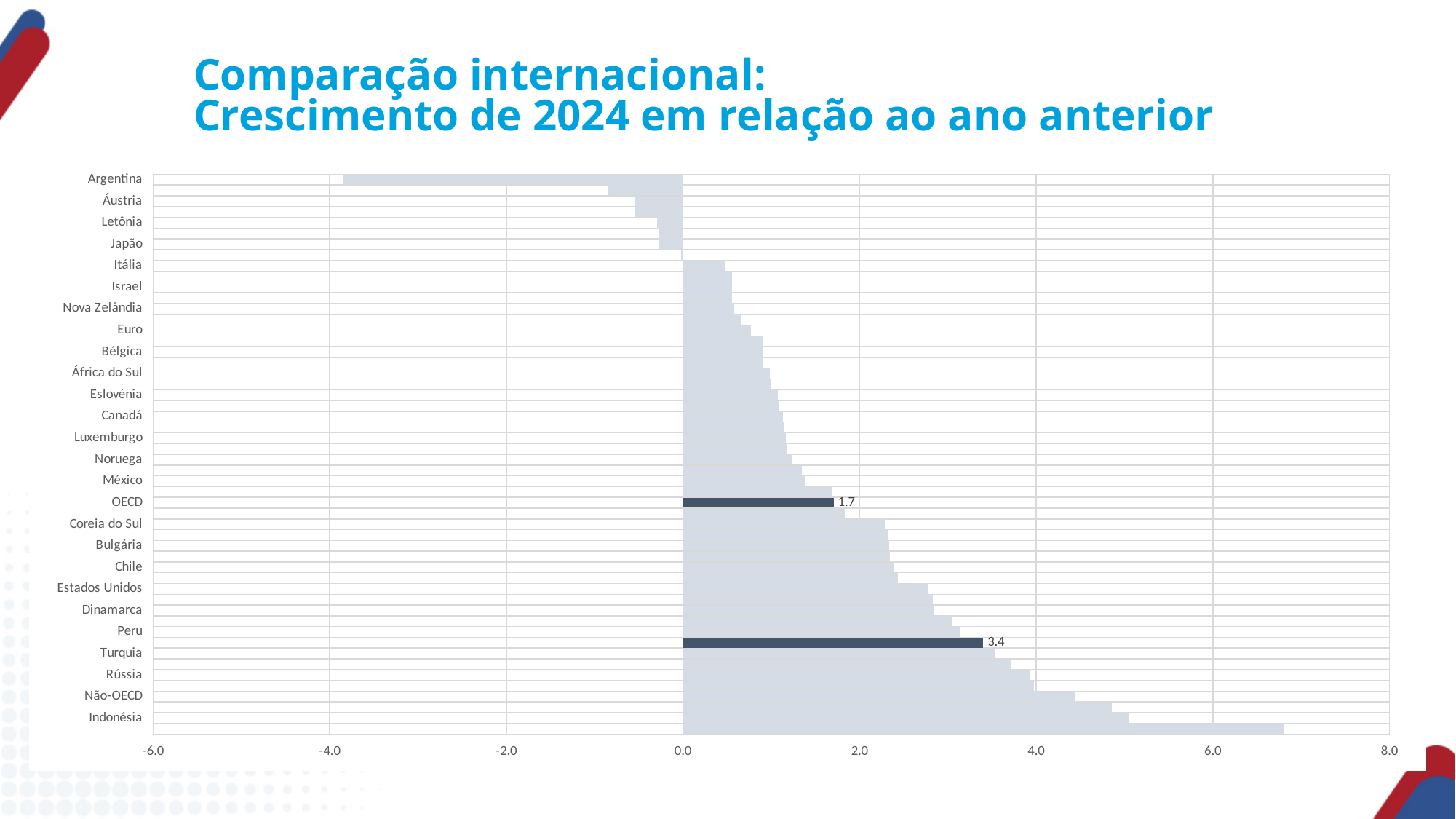
What kind of chart is shown on the slide? bar chart What is the title of the slide's chart? Comparação internacional: Crescimento de 2024 em relação ao ano anterior Is the value for Japão greater or less than 0.0? less Which has the larger value, Argentina or Indonésia? Indonésia What are the minimum and maximum values shown on the horizontal axis? -6.0 and 8.0 Is the value for Indonésia greater or less than 4.0? greater Which labeled category has the lowest value? Argentina What value is printed on the OECD bar? 1.7 Is the value for Argentina greater or less than -2.0? less Do the bar values rise or fall going from the top of the chart (Argentina) to the bottom (Indonésia)? rise What value is printed on the second dark highlighted bar, located between Peru and Turquia? 3.4